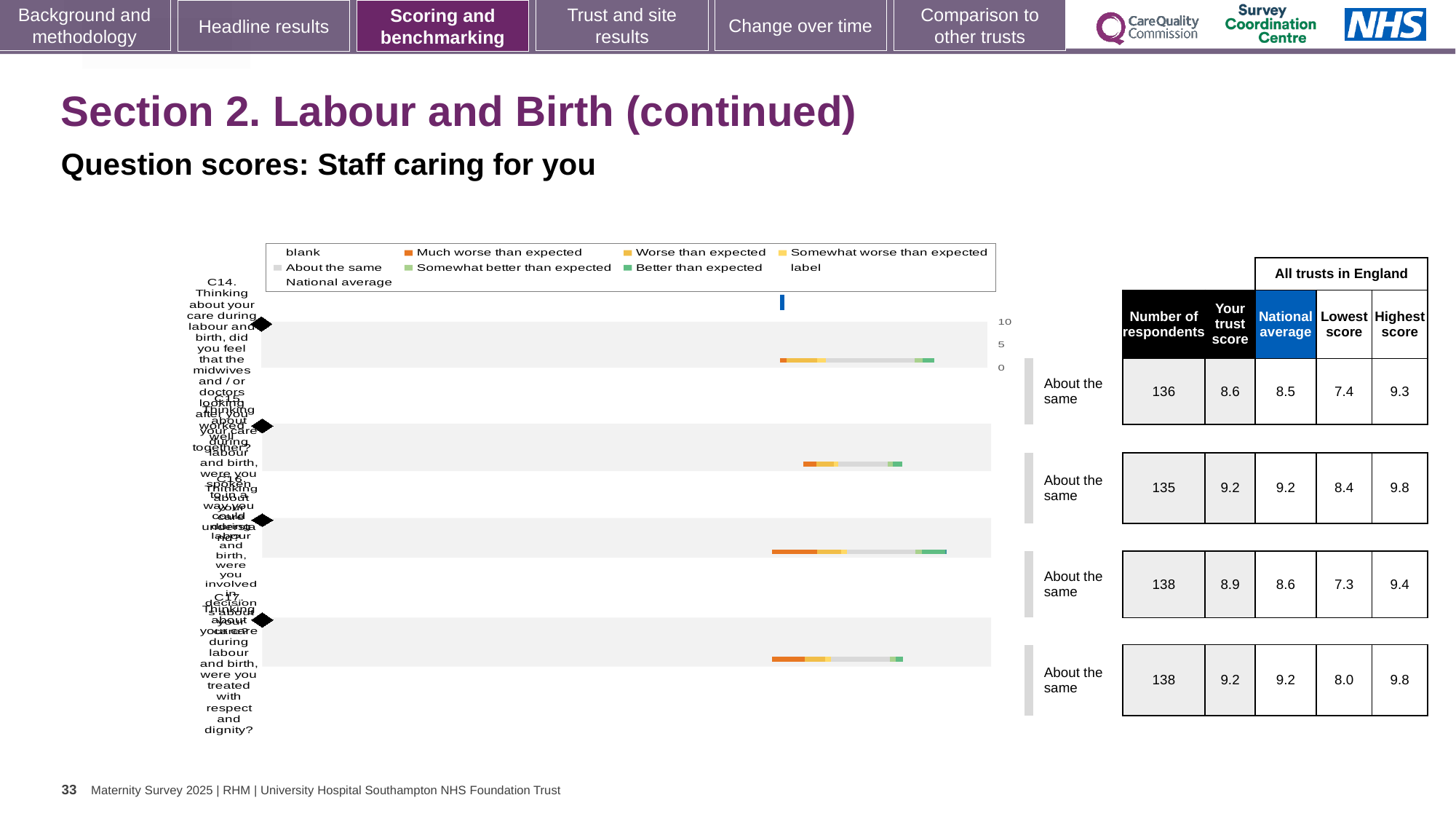
What is the 'Highest score' shown for the last (bottom) question row about being treated with respect and dignity? 9.8 How many question rows are plotted on the chart? 4 What is the 'Your trust score' for the first (top) question, C14 about midwives and/or doctors working well together? 8.6 For the third question row, how much higher is the trust score (8.9) than the national average (8.6)? 0.3 For the first (top) question row, is the trust score higher or lower than the national average? higher What is the national average shown for the first (top) question row? 8.5 What is the smallest value in the 'Lowest score' column? 7.3 What colour represents 'Much worse than expected' in the chart legend? orange For the second question row, what is the difference between the highest score (9.8) and the lowest score (8.4)? 1.4 What kind of chart is shown on the slide? bar chart How many respondents are listed for the second question row? 135 What benchmark category label is shown next to every question row? About the same